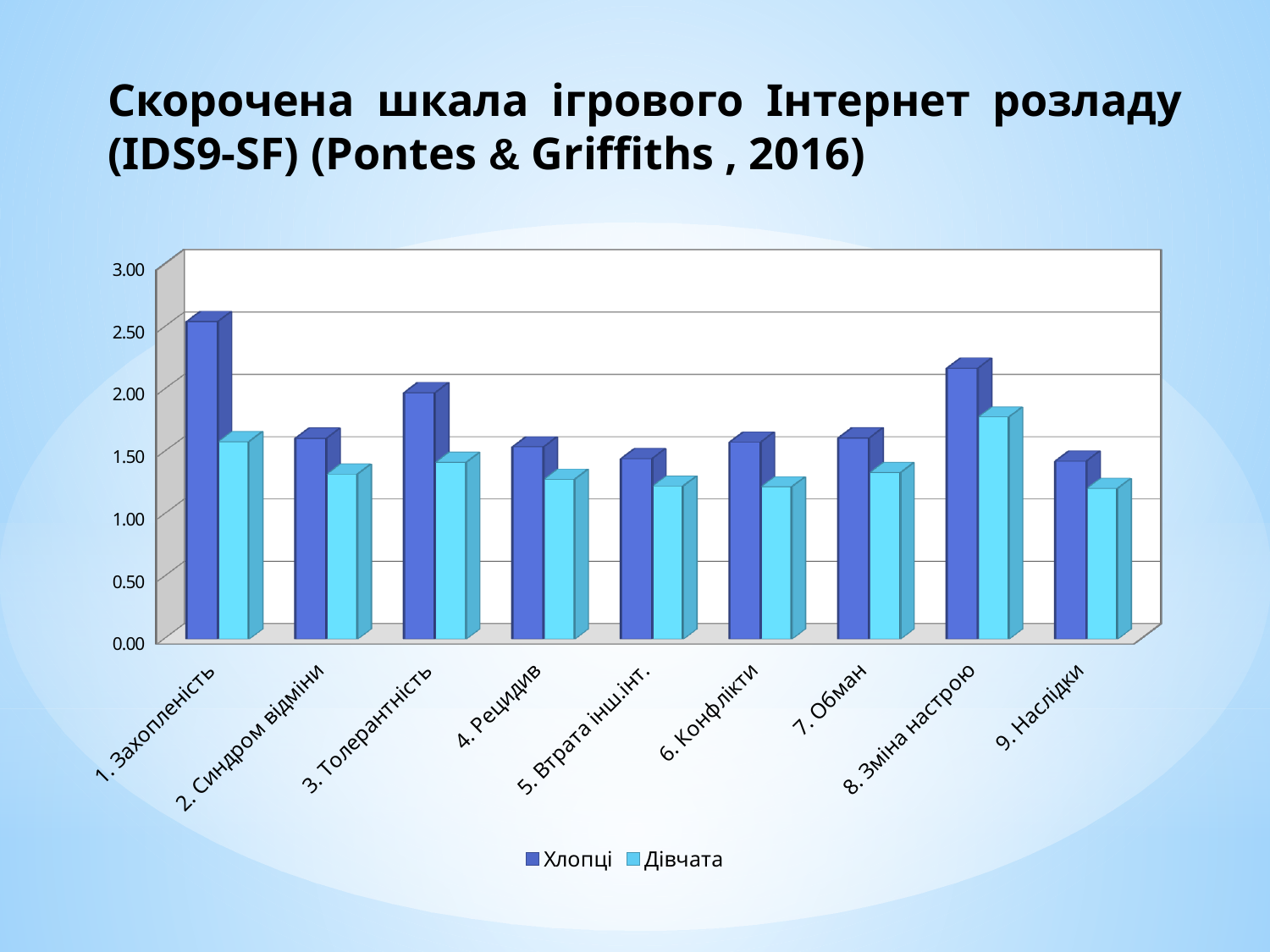
For Хлопці, which is larger: the value for 1. Захопленість or the value for 8. Зміна настрою? 1. Захопленість How many categories are shown on the x axis? 9 How many series does the legend list? 2 Is the value for Хлопці in 8. Зміна настрою greater or less than 2.00? greater Which category has the highest value for Дівчата? 8. Зміна настрою Is the value for Дівчата in 1. Захопленість greater or less than 2.00? less Is the value for Дівчата in 4. Рецидив greater or less than 1.50? less What kind of chart is shown on the slide? Bar chart What are the two series named in the legend? Хлопці and Дівчата Which category has the highest value for Хлопці? 1. Захопленість In 1. Захопленість, which series has the larger value, Хлопці or Дівчата? Хлопці